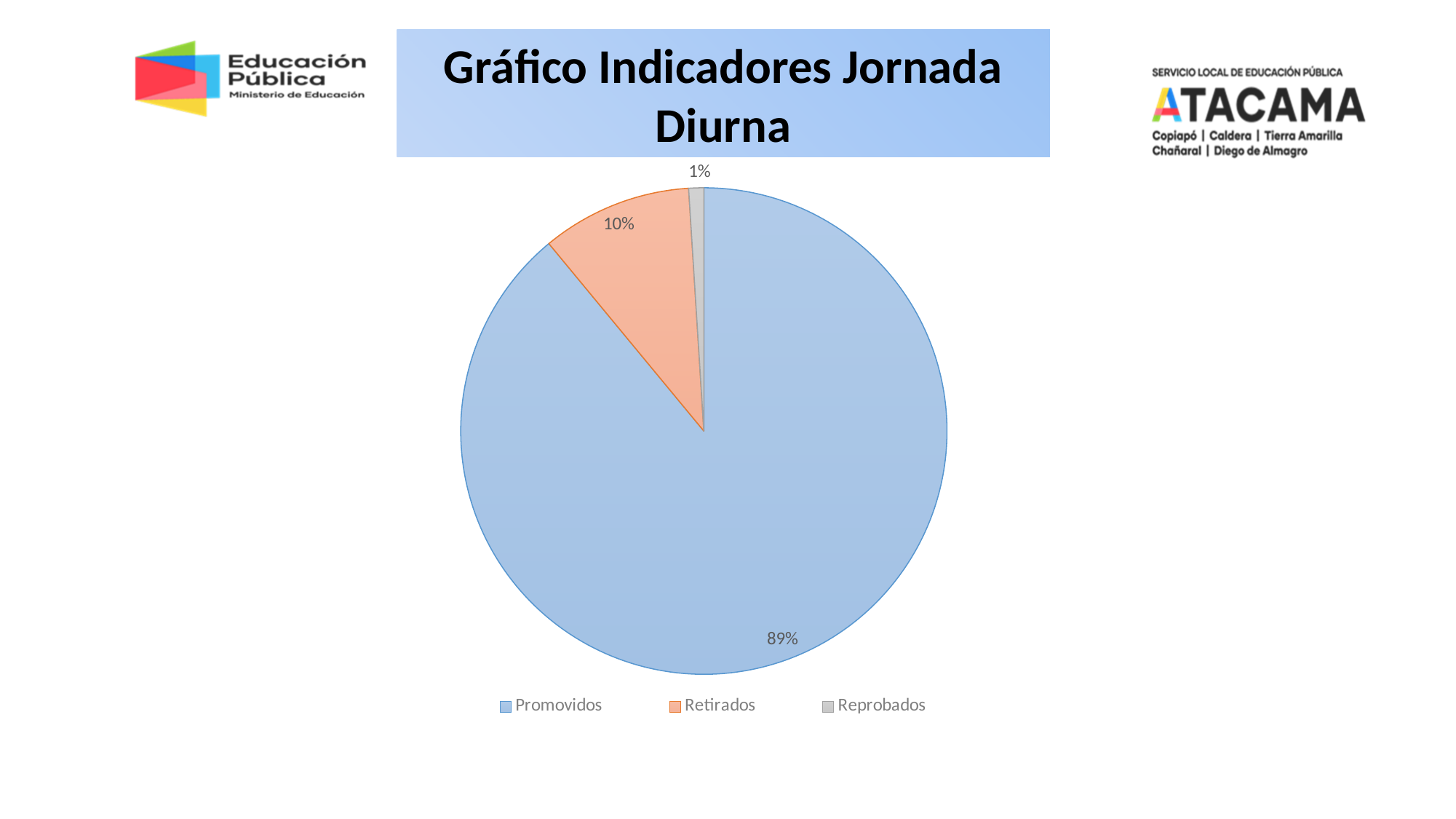
What is the title of the chart? Gráfico Indicadores Jornada Diurna What colour is the Retirados slice? orange Which category has the smallest slice of the pie? Reprobados How many entries does the legend list? 3 What share of the pie is Reprobados? 1% What is the difference in percentage points between the Promovidos share and the Retirados share? 79 percentage points What kind of chart is shown on the slide? pie chart What share of the pie is Promovidos? 89% How many slices does the pie chart have? 3 What share of the pie is Retirados? 10% Which category has the largest slice of the pie? Promovidos Which is larger, the share for Retirados or the share for Reprobados? Retirados